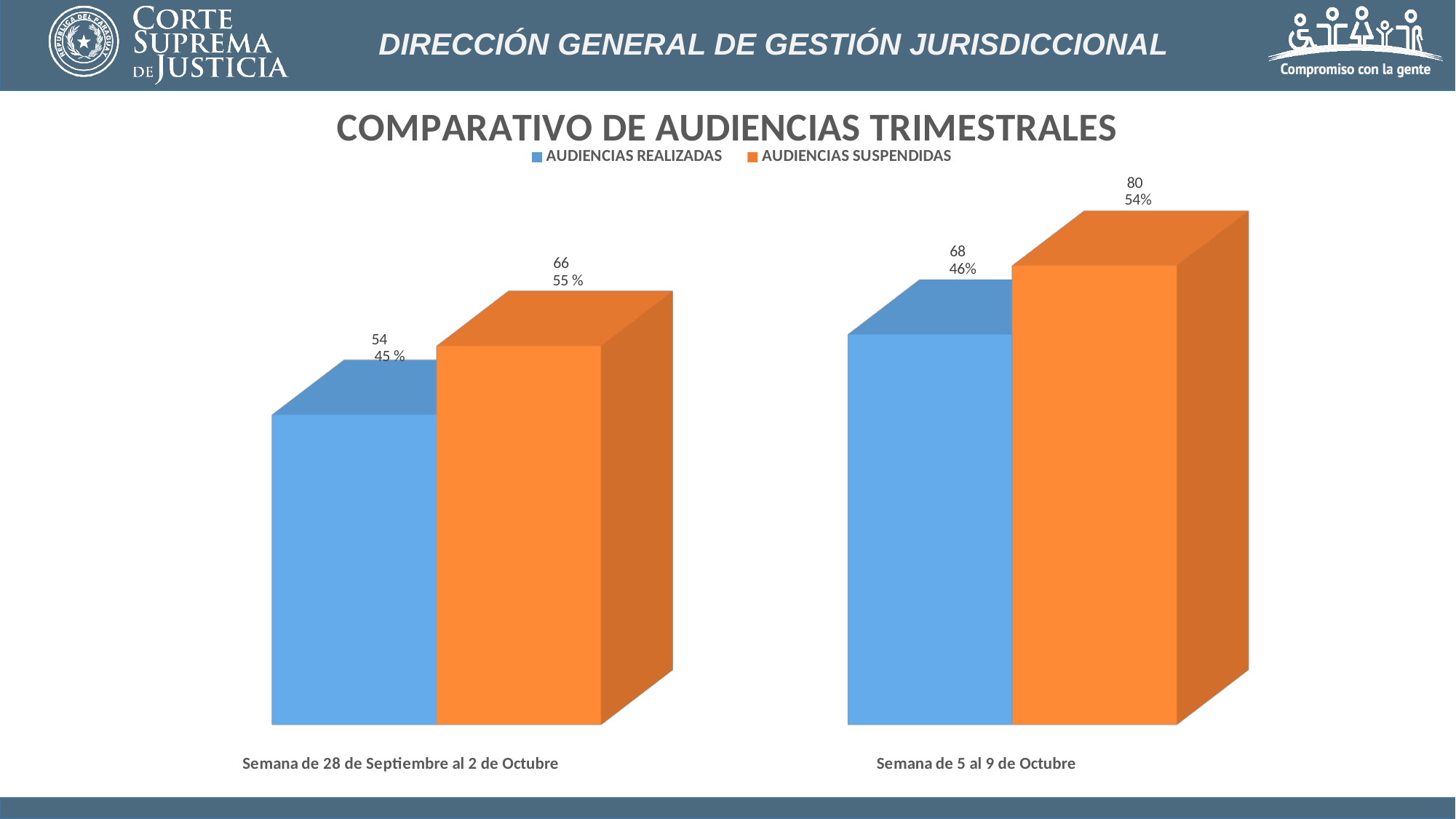
How many categories (weeks) are shown on the x axis? 2 What percentage is shown for AUDIENCIAS REALIZADAS in the week 'Semana de 5 al 9 de Octubre'? 46% What is the value for AUDIENCIAS SUSPENDIDAS in the week 'Semana de 5 al 9 de Octubre'? 80 What is the difference in AUDIENCIAS REALIZADAS between the week of 5 al 9 de Octubre and the week of 28 de Septiembre al 2 de Octubre? 14 What is the difference between AUDIENCIAS SUSPENDIDAS and AUDIENCIAS REALIZADAS in the week 'Semana de 5 al 9 de Octubre'? 12 What is the value for AUDIENCIAS SUSPENDIDAS in the week 'Semana de 28 de Septiembre al 2 de Octubre'? 66 In the week 'Semana de 28 de Septiembre al 2 de Octubre', which is larger: AUDIENCIAS REALIZADAS or AUDIENCIAS SUSPENDIDAS? AUDIENCIAS SUSPENDIDAS Which bar has the lowest value on the chart? AUDIENCIAS REALIZADAS, Semana de 28 de Septiembre al 2 de Octubre How many series does the legend list? 2 Which bar has the highest value on the chart? AUDIENCIAS SUSPENDIDAS, Semana de 5 al 9 de Octubre What kind of chart is shown on the slide? Bar chart What is the value for AUDIENCIAS REALIZADAS in the week 'Semana de 28 de Septiembre al 2 de Octubre'? 54